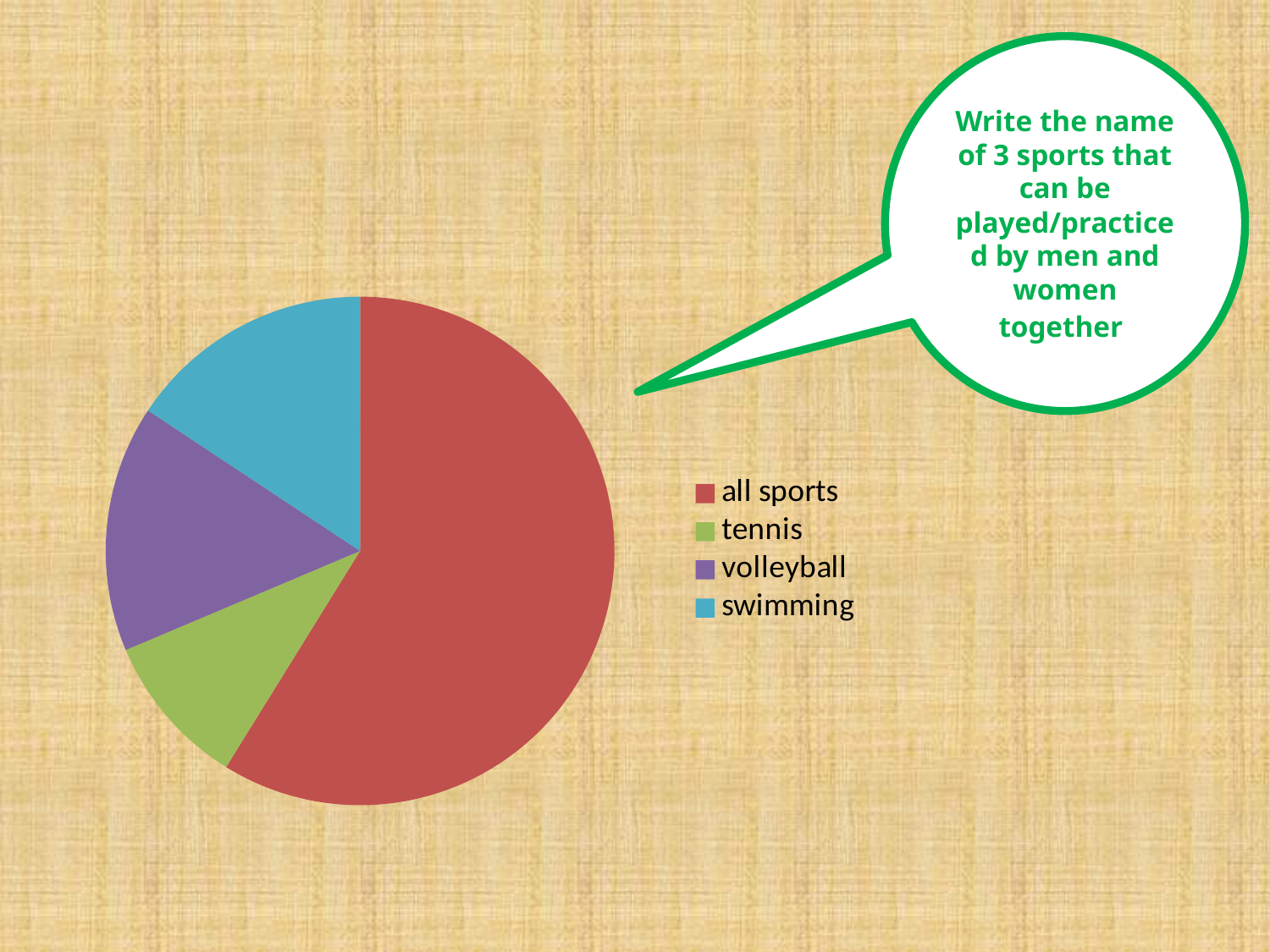
How many slices does the pie chart have? 4 What kind of chart is shown on the slide? pie chart Which slice is larger in the pie chart, all sports or tennis? all sports How many entries does the legend of the pie chart list? 4 Which slice is larger in the pie chart, tennis or volleyball? volleyball Which slice is larger in the pie chart, all sports or swimming? all sports Which category is shown in blue in the pie chart? swimming Which category has the smallest slice of the pie chart? tennis What colour is the all sports slice in the pie chart? red Which category has the largest slice of the pie chart? all sports